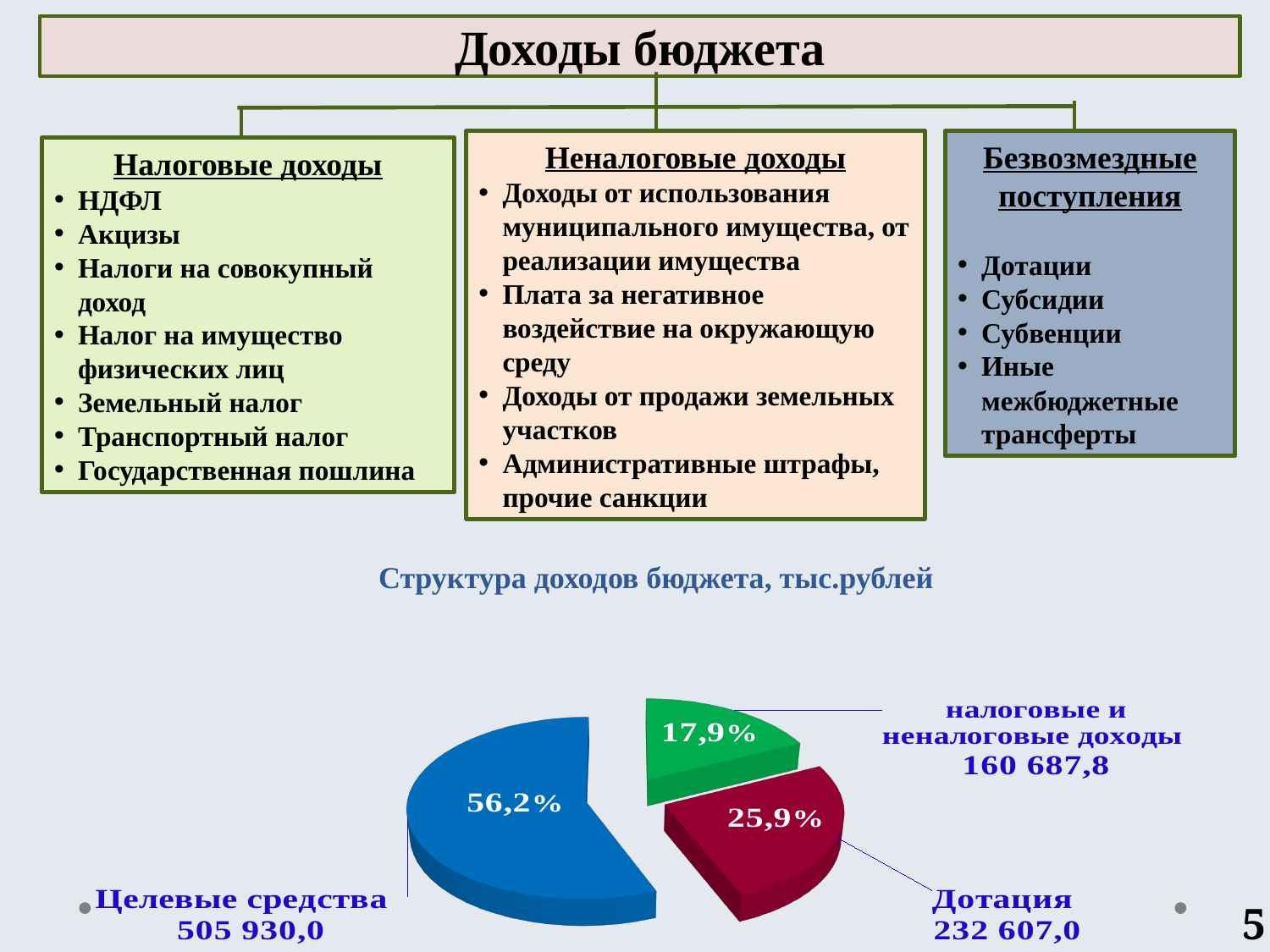
What share of the pie does Целевые средства take? 56,2% What is the difference between the values for Целевые средства and Дотация? 273 323,0 Which category has the largest slice? Целевые средства How many slices does the pie chart have? 3 What kind of chart is shown on the slide? pie chart Which category has the smallest slice? налоговые и неналоговые доходы What share of the pie do налоговые и неналоговые доходы take? 17,9% What is the value for Целевые средства? 505 930,0 What is the title of the chart? Структура доходов бюджета, тыс.рублей What is the value for Дотация? 232 607,0 What is the value for налоговые и неналоговые доходы? 160 687,8 What share of the pie does Дотация take? 25,9%